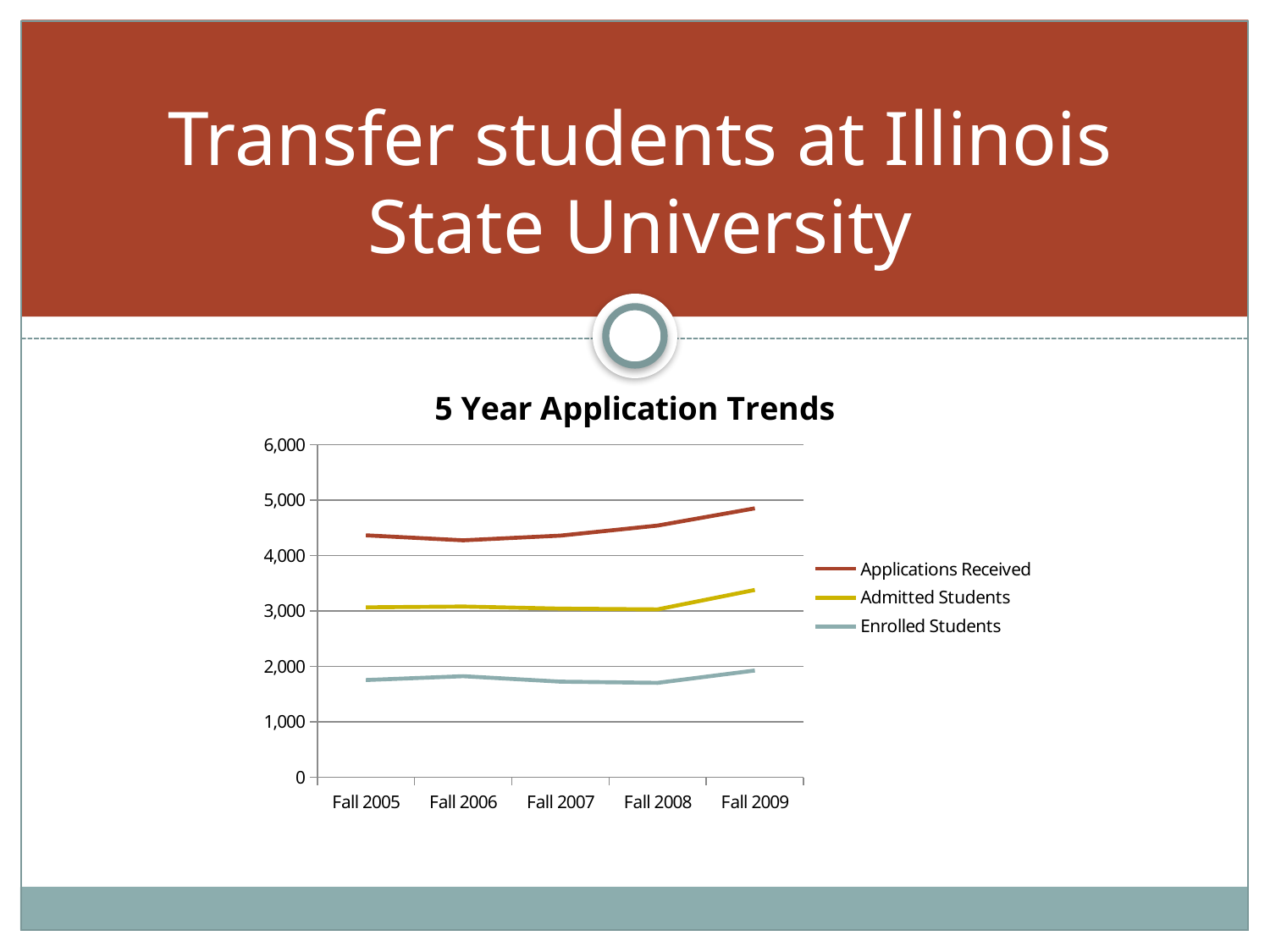
Which series has the lowest values across all years? Enrolled Students How many series does the legend list? 3 Which is larger in Fall 2009: Admitted Students or Enrolled Students? Admitted Students What type of chart is shown on the slide? line chart Which series is drawn in yellow? Admitted Students How many points are plotted along the x axis for each series? 5 Is the value for Admitted Students in Fall 2009 greater or less than 3,000? greater What is the title of the chart? 5 Year Application Trends Is the value for Applications Received in Fall 2009 greater or less than 4,000? greater Is the value for Enrolled Students in Fall 2008 greater or less than 2,000? less Does the Applications Received line rise or fall from Fall 2006 to Fall 2009? rise Which series has the highest values across all years? Applications Received